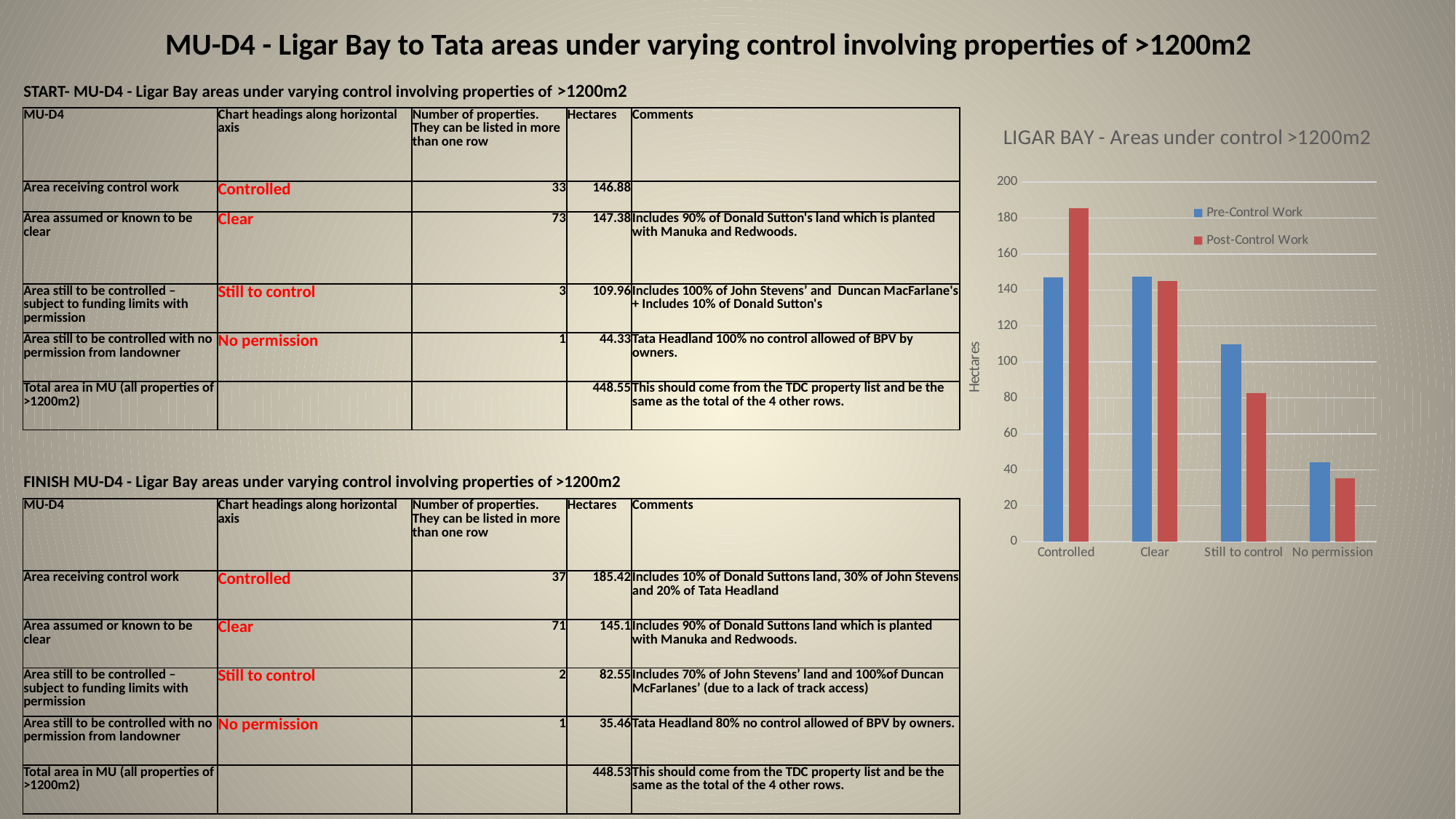
Is the Pre-Control Work value for Still to control greater or less than 100? greater How many categories are shown on the x axis of the chart? 4 What type of chart is shown on the slide? bar chart For the Still to control category, which is larger: Pre-Control Work or Post-Control Work? Pre-Control Work Is the Post-Control Work value for Controlled greater or less than 180? greater Which category has the lowest Pre-Control Work value? No permission Do the Post-Control Work values rise or fall from Controlled to No permission along the x axis? fall How many series does the chart legend list? 2 For the Controlled category, which is larger: Pre-Control Work or Post-Control Work? Post-Control Work What is the label on the vertical axis of the chart? Hectares Is the Post-Control Work value for No permission greater or less than 40? less Which category has the highest Post-Control Work value? Controlled